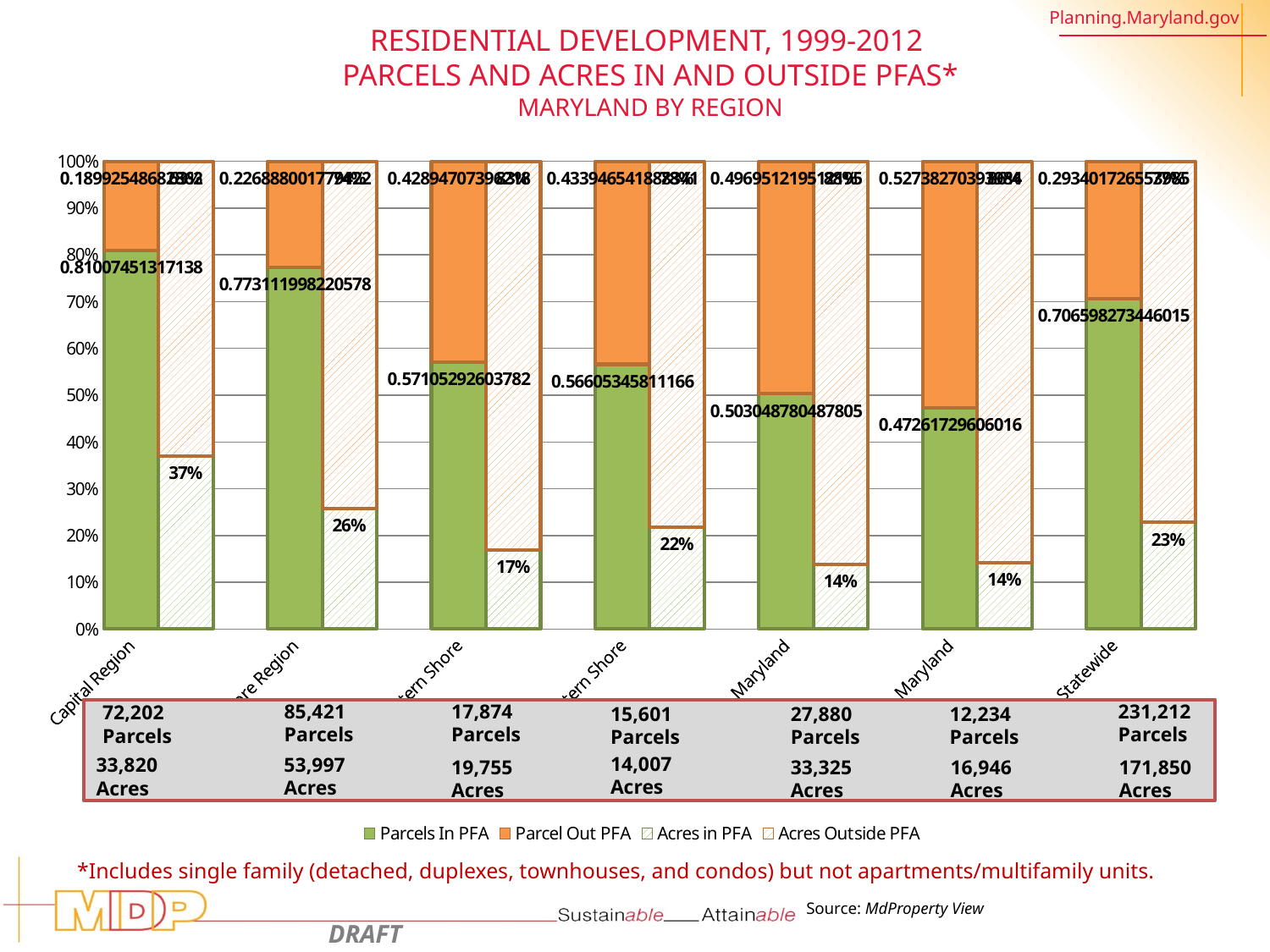
Is the Parcels In PFA share for Statewide greater or less than 60%? greater What is the Parcels In PFA value labelled for the Capital Region? 0.81007451317138 How many series does the legend list? 4 What is the first line of the chart's title? RESIDENTIAL DEVELOPMENT, 1999-2012 Which region has the highest Parcels In PFA share? Capital Region What type of chart is shown on the slide? Stacked bar chart What is the Acres in PFA value for the Capital Region? 37% What is the Acres in PFA value for Statewide? 23% Which region has the highest Acres in PFA share? Capital Region What is the difference between the Acres in PFA share for the Capital Region and for Statewide? 14% How many regions (categories) are plotted along the x axis? 7 What is the Parcels In PFA value labelled for Statewide? 0.706598273446015